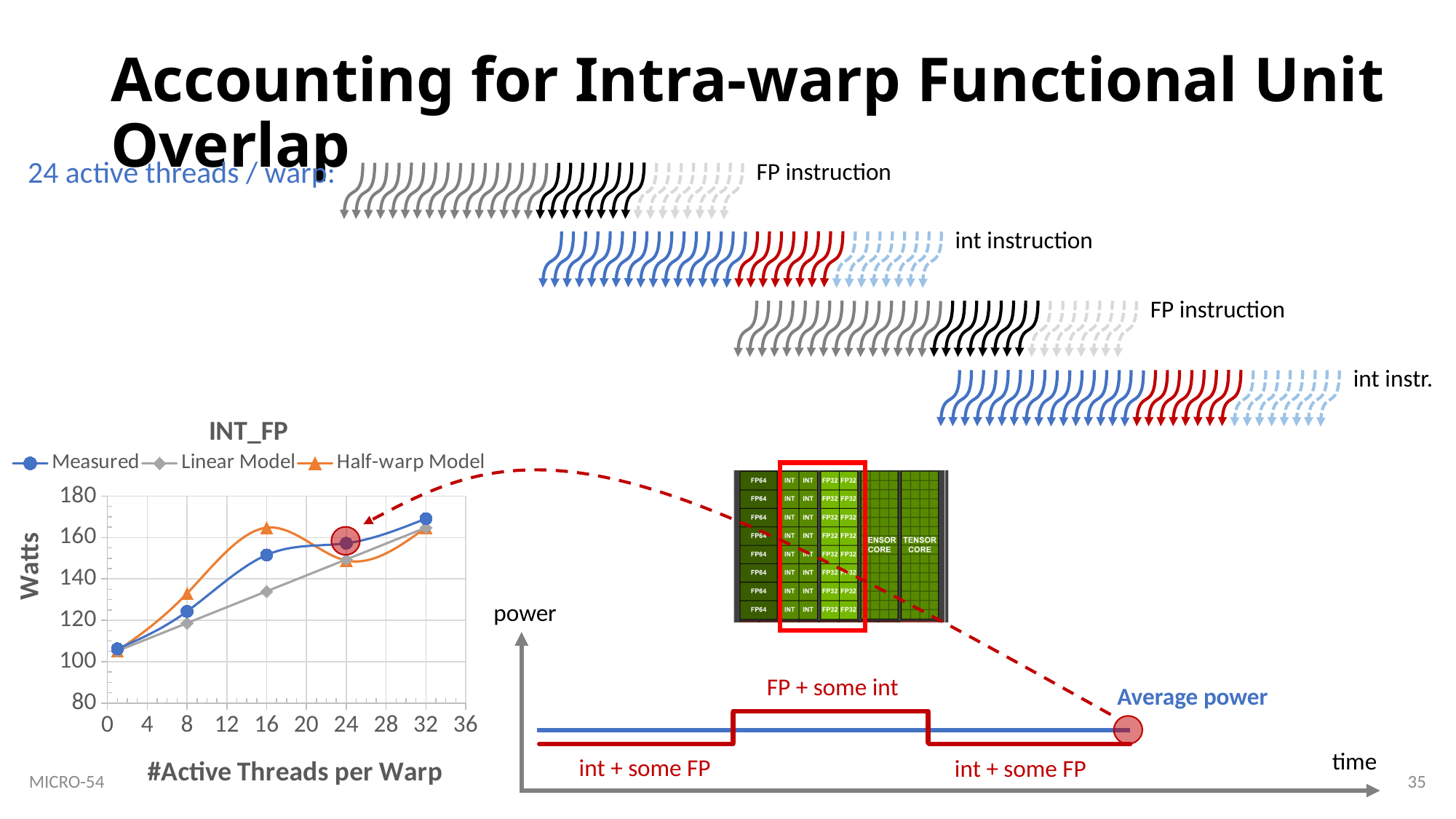
In the INT_FP chart, does the Linear Model series rise or fall as the number of active threads per warp increases? rise In the INT_FP chart, at 16 active threads per warp, which is larger: the Half-warp Model value or the Linear Model value? Half-warp Model What is the y-axis label of the INT_FP chart? Watts In the INT_FP chart, is the Half-warp Model value at 24 active threads per warp greater or less than 160? less In the INT_FP chart, is the Linear Model value at 16 active threads per warp greater or less than 140? less What kind of chart is the INT_FP chart? line chart In the INT_FP chart, at 24 active threads per warp, which is larger: the Measured value or the Half-warp Model value? Measured In the INT_FP chart, is the Half-warp Model value at 16 active threads per warp greater or less than 160? greater How many series does the legend of the INT_FP chart list? 3 What is the title of the chart on the slide? INT_FP How many data points does the Measured series have in the INT_FP chart? 5